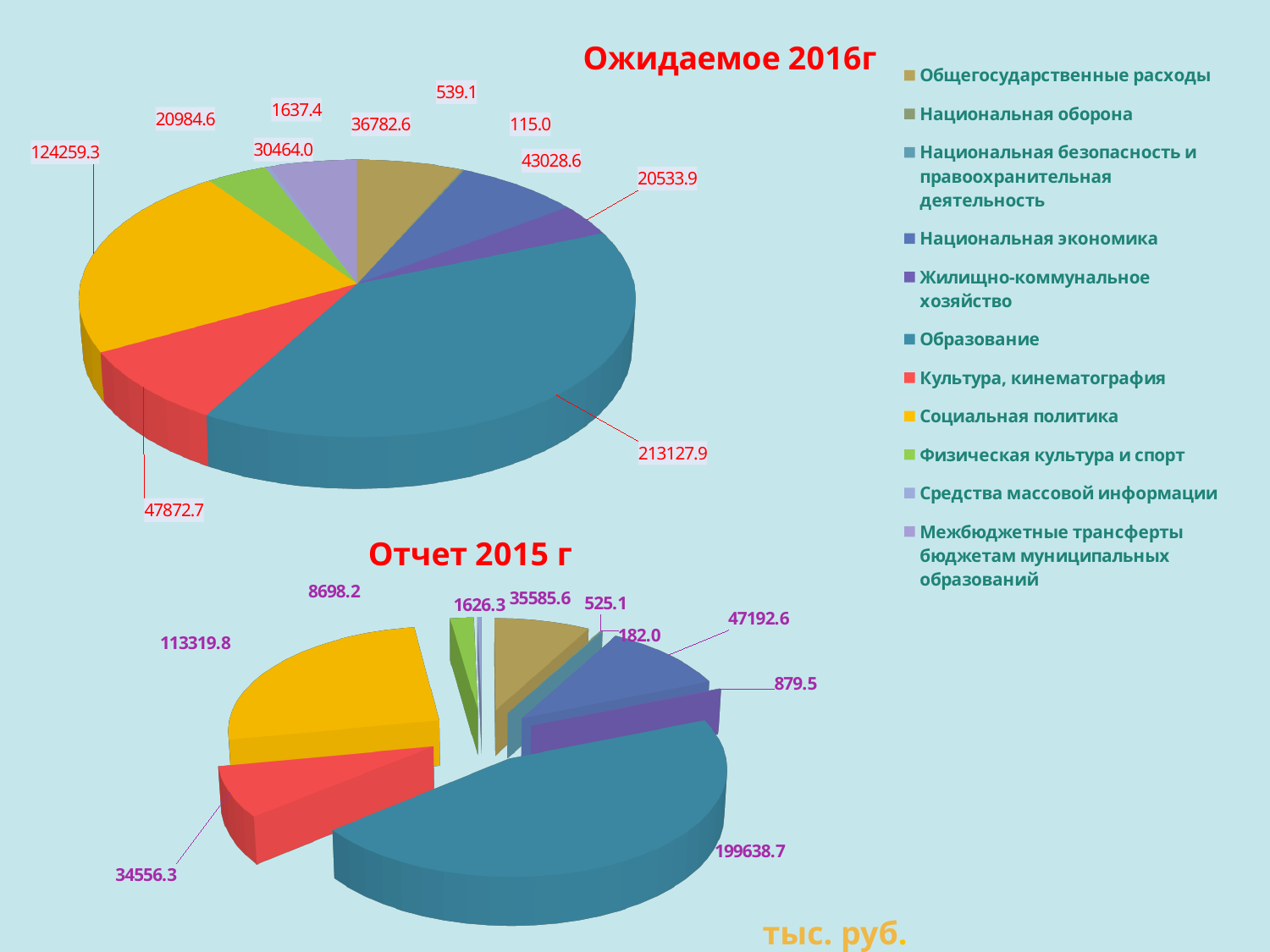
What is the difference between the Образование value in "Ожидаемое 2016г" and in "Отчет 2015 г"? 13489.2 How many categories does the legend list? 11 In the "Отчет 2015 г" chart, what is the value for Образование? 199638.7 What unit is shown at the bottom right of the slide for the chart values? тыс. руб. In the "Ожидаемое 2016г" chart, which is larger: Социальная политика or Культура, кинематография? Социальная политика What type of chart is used for "Ожидаемое 2016г"? Pie chart In the "Отчет 2015 г" chart, what is the value for Социальная политика? 113319.8 In the "Отчет 2015 г" chart, what is the value for Культура, кинематография? 34556.3 In the "Ожидаемое 2016г" chart, what is the value for Социальная политика? 124259.3 In the "Ожидаемое 2016г" chart, what is the value for Культура, кинематография? 47872.7 In the "Ожидаемое 2016г" chart, what is the value for Образование? 213127.9 Which category has the largest slice in the "Ожидаемое 2016г" chart? Образование